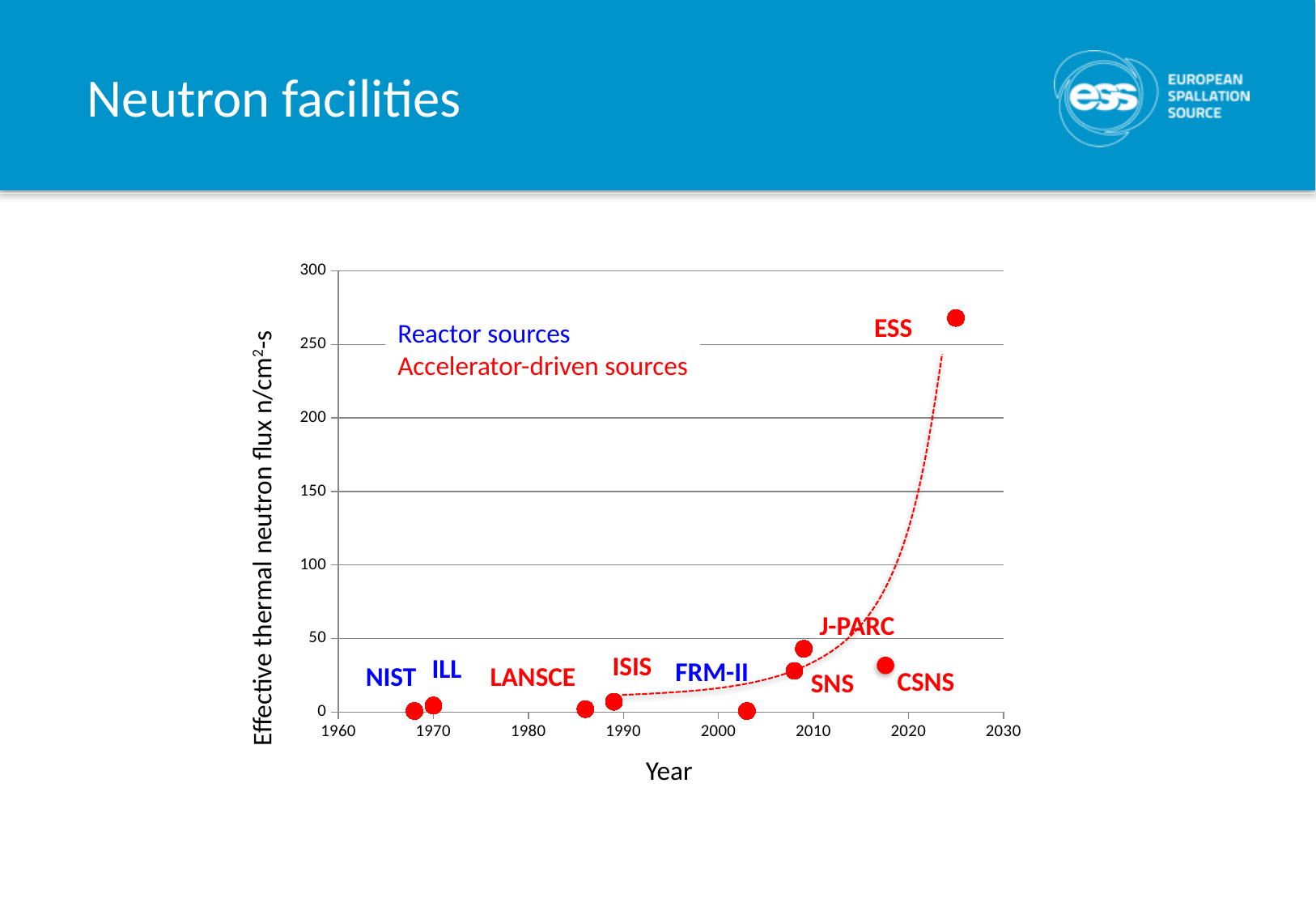
Which facility has the highest effective thermal neutron flux on the chart? ESS How many facilities are plotted on the chart? 9 What is the label of the y axis? Effective thermal neutron flux n/cm²-s Is the value for ESS greater or less than 250? greater Is the value for CSNS greater or less than 50? less Which has the larger effective thermal neutron flux, J-PARC or SNS? J-PARC Which has the larger effective thermal neutron flux, ESS or J-PARC? ESS Is the value for ESS greater or less than 200? greater What kind of chart is shown on the slide? scatter chart In what colour are the reactor sources labelled on the chart? blue Do the plotted flux values generally rise or fall as the year increases? rise